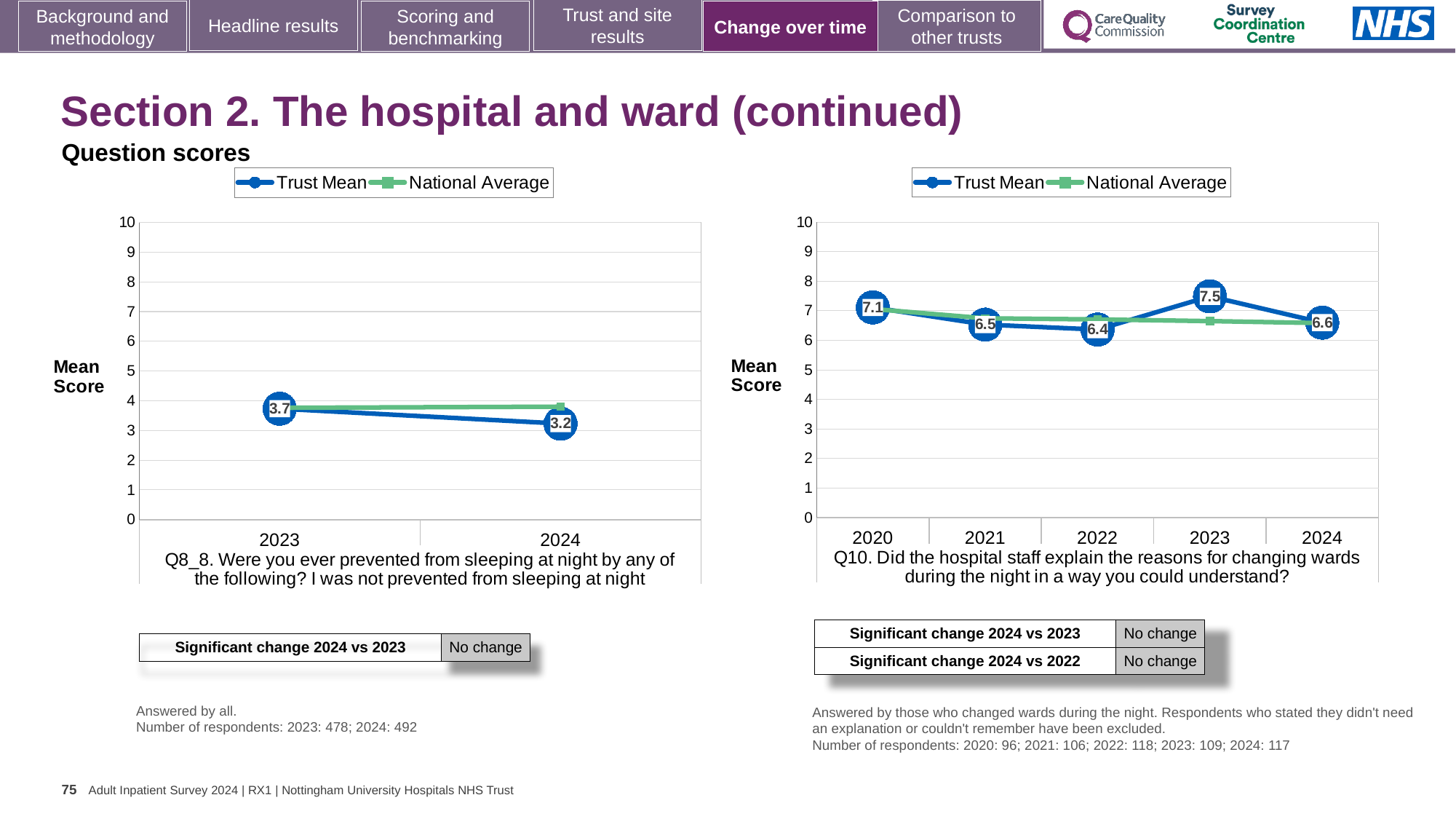
In the right chart (Q10), what is the Trust Mean score for 2020? 7.1 In the left chart (Q8_8), what is the Trust Mean score for 2024? 3.2 In the left chart (Q8_8), does the Trust Mean rise or fall from 2023 to 2024? fall In the right chart (Q10), is the Trust Mean higher in 2021 or in 2023? 2023 In the right chart (Q10), which year has the lowest Trust Mean score? 2022 In the right chart (Q10), what is the difference between the Trust Mean in 2023 and in 2024? 0.9 In the right chart (Q10), which year has the highest Trust Mean score? 2023 How many series does the legend of the left chart (Q8_8) list? 2 In the left chart (Q8_8), what is the Trust Mean score for 2023? 3.7 In the right chart (Q10), what is the Trust Mean score for 2022? 6.4 In the right chart (Q10), how many years are plotted on the x axis? 5 In the left chart (Q8_8), by how much did the Trust Mean fall from 2023 to 2024? 0.5